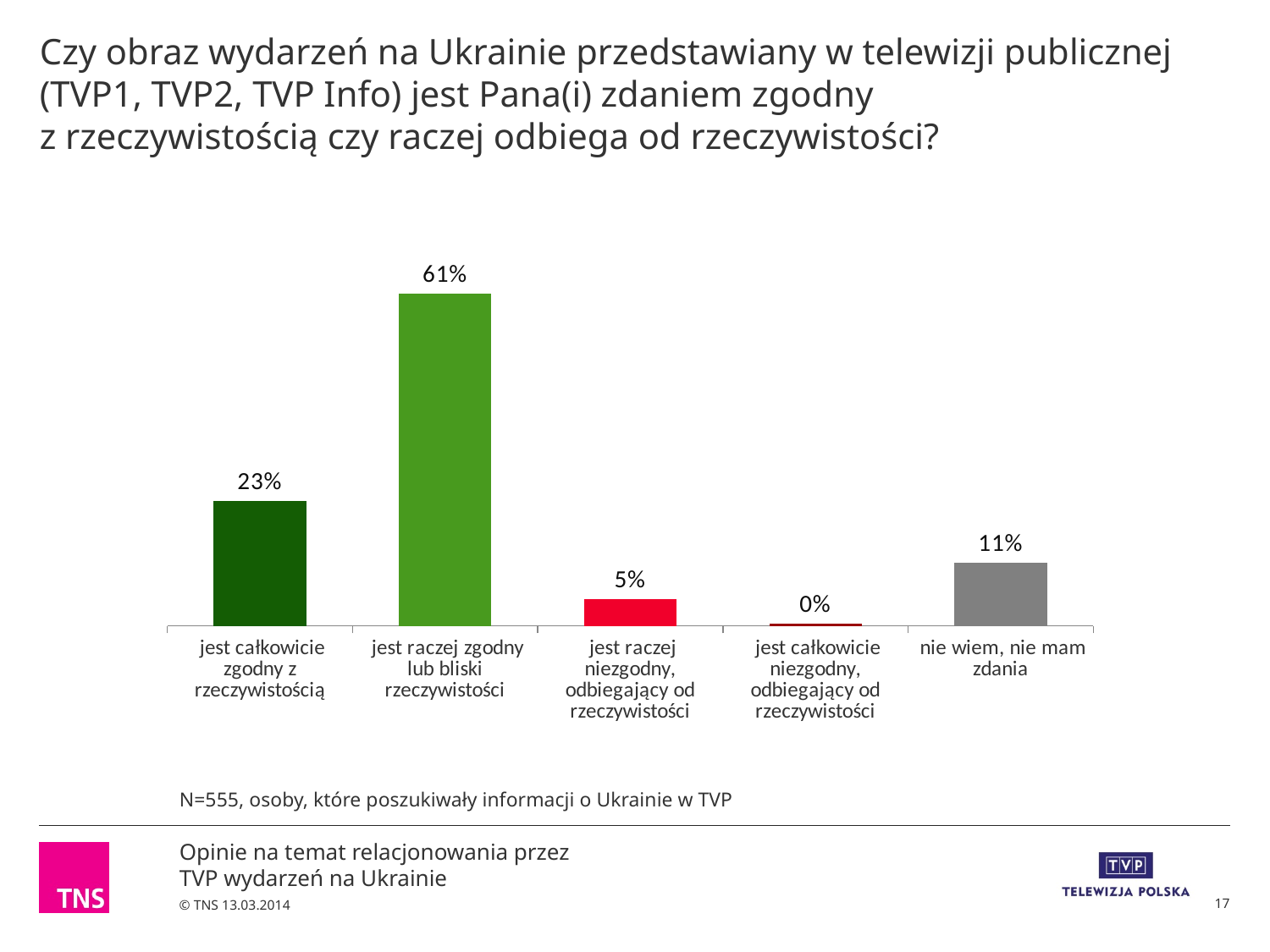
What percentage of respondents said the picture of events in Ukraine on public television is 'jest raczej zgodny lub bliski rzeczywistości'? 61% What is the sample size (N) stated below the chart? N=555 What is the value for 'nie wiem, nie mam zdania'? 11% Which category has the highest value? jest raczej zgodny lub bliski rzeczywistości What is the value for 'jest całkowicie zgodny z rzeczywistością'? 23% What is the value for 'jest całkowicie niezgodny, odbiegający od rzeczywistości'? 0% Which is larger: 'jest całkowicie zgodny z rzeczywistością' or 'nie wiem, nie mam zdania'? jest całkowicie zgodny z rzeczywistością What is the difference between 'jest raczej zgodny lub bliski rzeczywistości' and 'jest całkowicie zgodny z rzeczywistością'? 38% What kind of chart is shown on the slide? bar chart What is the difference between 'nie wiem, nie mam zdania' and 'jest raczej niezgodny, odbiegający od rzeczywistości'? 6% How many categories are shown in the chart? 5 Which category has the lowest value? jest całkowicie niezgodny, odbiegający od rzeczywistości